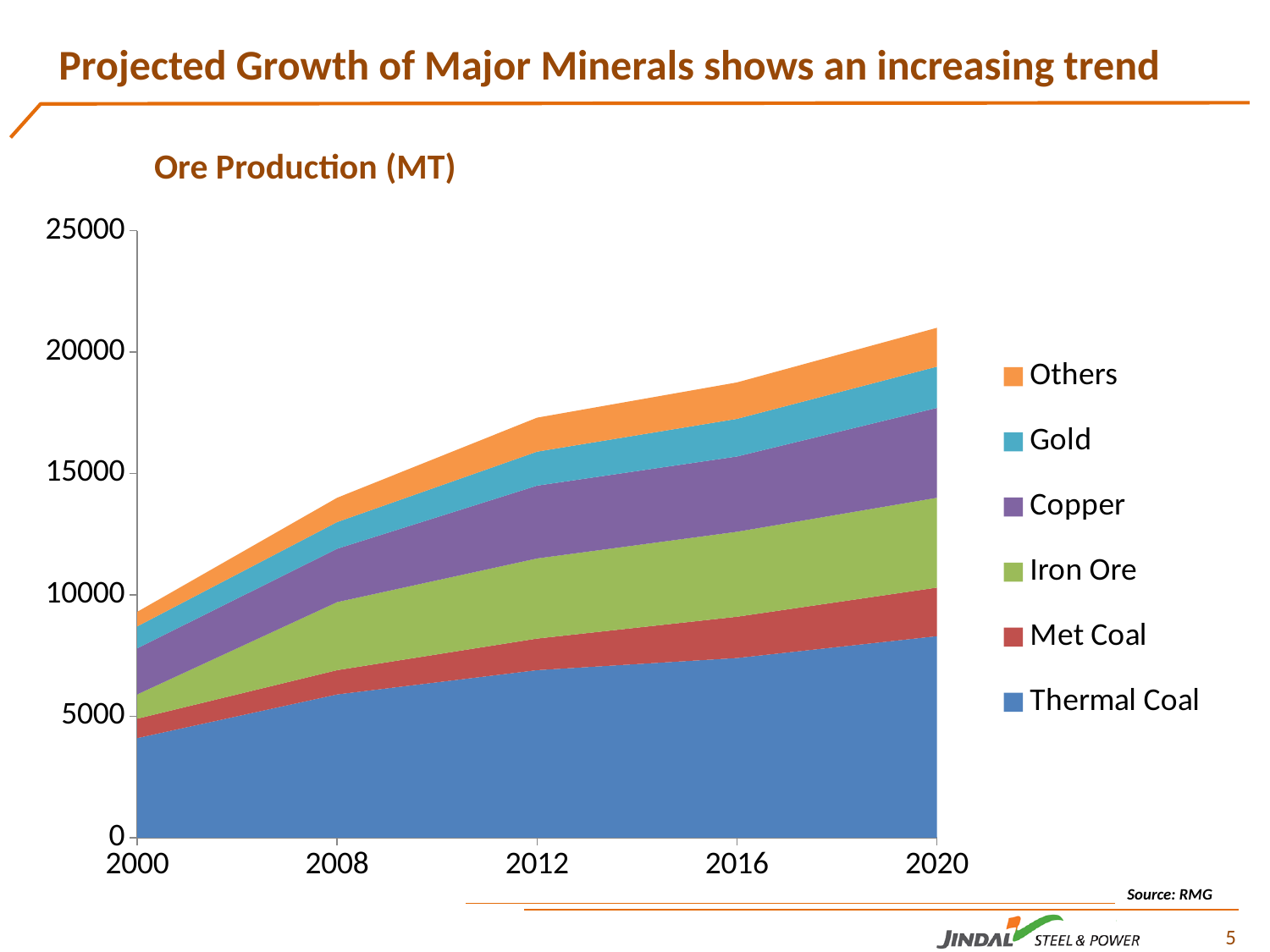
How many years are marked along the x axis? 5 Which year has the highest total ore production? 2020 Which is larger, the total ore production in 2008 or in 2016? 2016 Is the total ore production in 2012 greater or less than 15000? greater What is the title of the chart? Ore Production (MT) Is the Thermal Coal value in 2020 greater or less than 5000? greater What kind of chart is shown on the slide? Stacked area chart Does total ore production rise or fall from 2000 to 2020? Rise Is the total ore production in 2000 greater or less than 10000? less How many series does the legend list? 6 Which year has the lowest total ore production? 2000